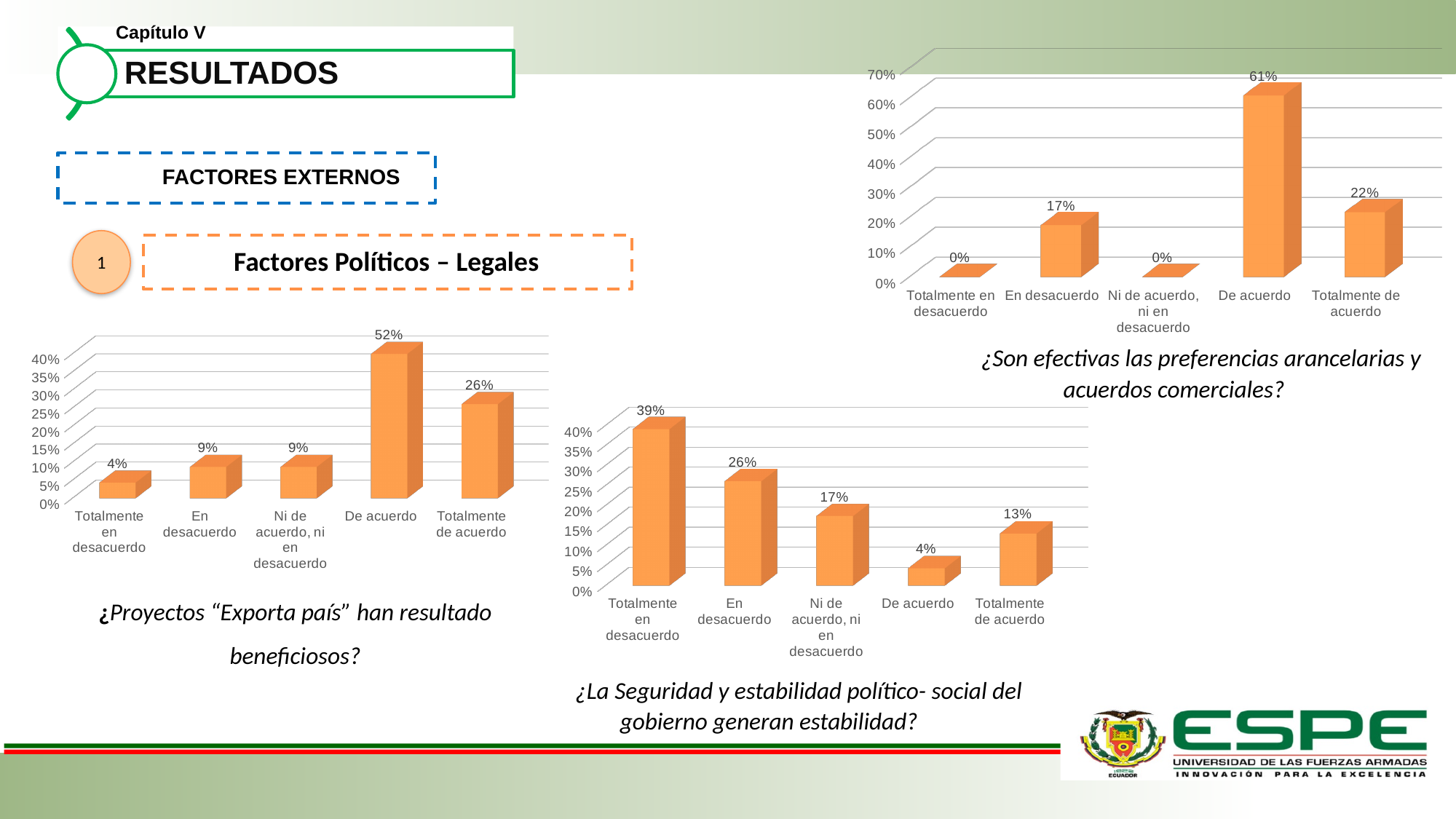
What kind of chart is used for "¿Proyectos “Exporta país” han resultado beneficiosos?"? bar chart In the chart captioned "¿Proyectos “Exporta país” han resultado beneficiosos?", which category has the lowest value? Totalmente en desacuerdo In the chart captioned "¿La Seguridad y estabilidad político- social del gobierno generan estabilidad?", which category has the highest value? Totalmente en desacuerdo In the chart captioned "¿Proyectos “Exporta país” han resultado beneficiosos?", what is the difference between De acuerdo and Totalmente de acuerdo? 26% In the chart captioned "¿La Seguridad y estabilidad político- social del gobierno generan estabilidad?", which is larger: Ni de acuerdo, ni en desacuerdo or Totalmente de acuerdo? Ni de acuerdo, ni en desacuerdo In the chart captioned "¿Son efectivas las preferencias arancelarias y acuerdos comerciales?", what is the difference between De acuerdo and En desacuerdo? 44% In the chart captioned "¿Son efectivas las preferencias arancelarias y acuerdos comerciales?", how many categories have a value of 0%? 2 In the chart captioned "¿La Seguridad y estabilidad político- social del gobierno generan estabilidad?", what is the value for Totalmente en desacuerdo? 39% In the chart captioned "¿Son efectivas las preferencias arancelarias y acuerdos comerciales?", what is the value for De acuerdo? 61% In the chart captioned "¿La Seguridad y estabilidad político- social del gobierno generan estabilidad?", do the values generally rise or fall from Totalmente en desacuerdo to De acuerdo? fall In the chart captioned "¿Son efectivas las preferencias arancelarias y acuerdos comerciales?", what is the value for Totalmente de acuerdo? 22% In the chart captioned "¿Proyectos “Exporta país” han resultado beneficiosos?", what is the value for De acuerdo? 52%